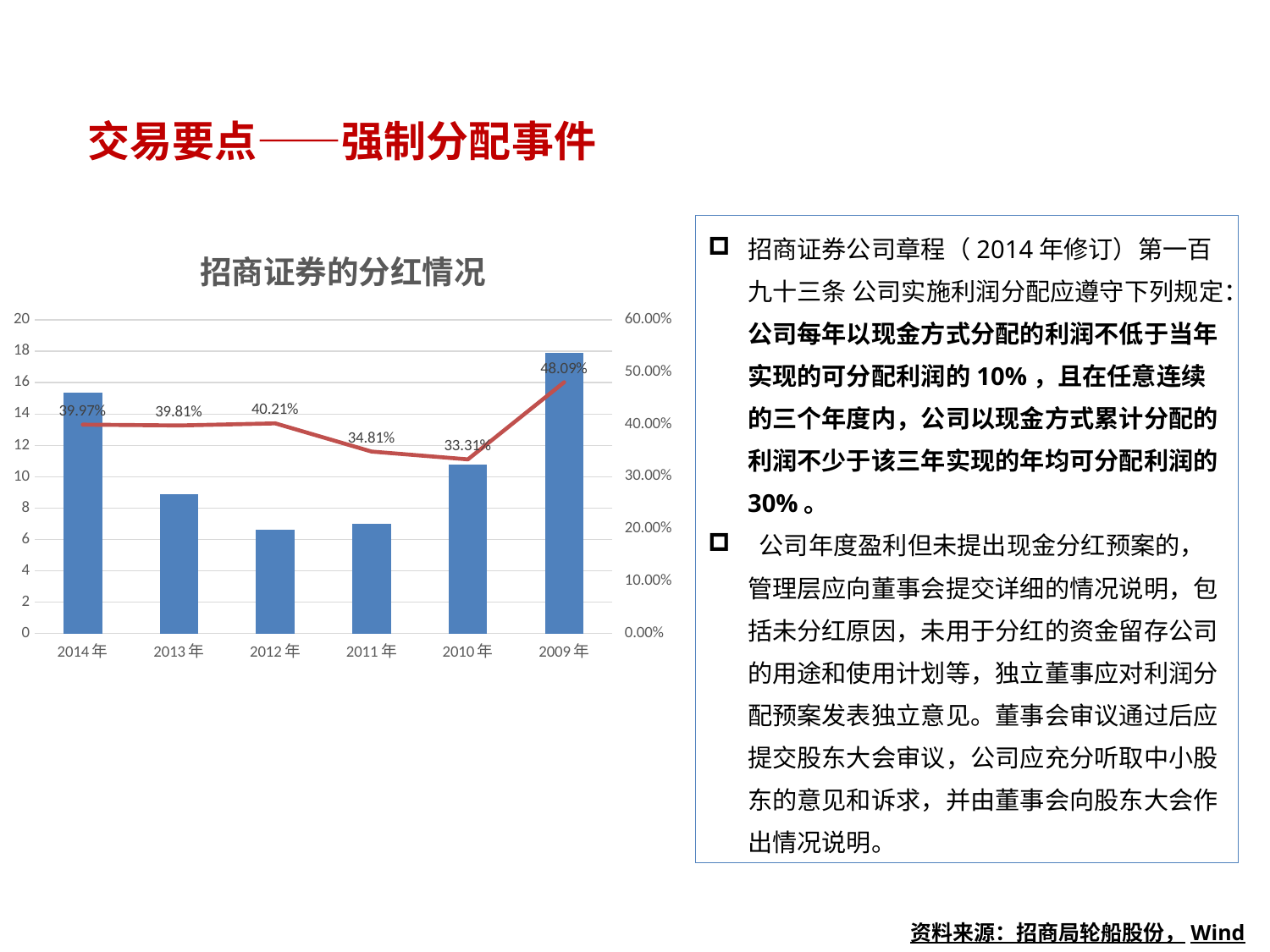
What kind of chart is this? Combined bar and line chart Which has a larger line value, 2012年 or 2011年? 2012年 Which year has the highest line value? 2009年 Which year has the lowest line value? 2010年 How many years are shown on the x axis? 6 What is the line value for 2011年? 34.81% What is the title of the chart? 招商证券的分红情况 What is the line value for 2009年? 48.09% What is the difference between the line values for 2009年 and 2010年? 14.78% Is the bar value for 2012年 greater or less than 8? less What is the line value for 2014年? 39.97% Is the bar value for 2014年 greater or less than 14? greater